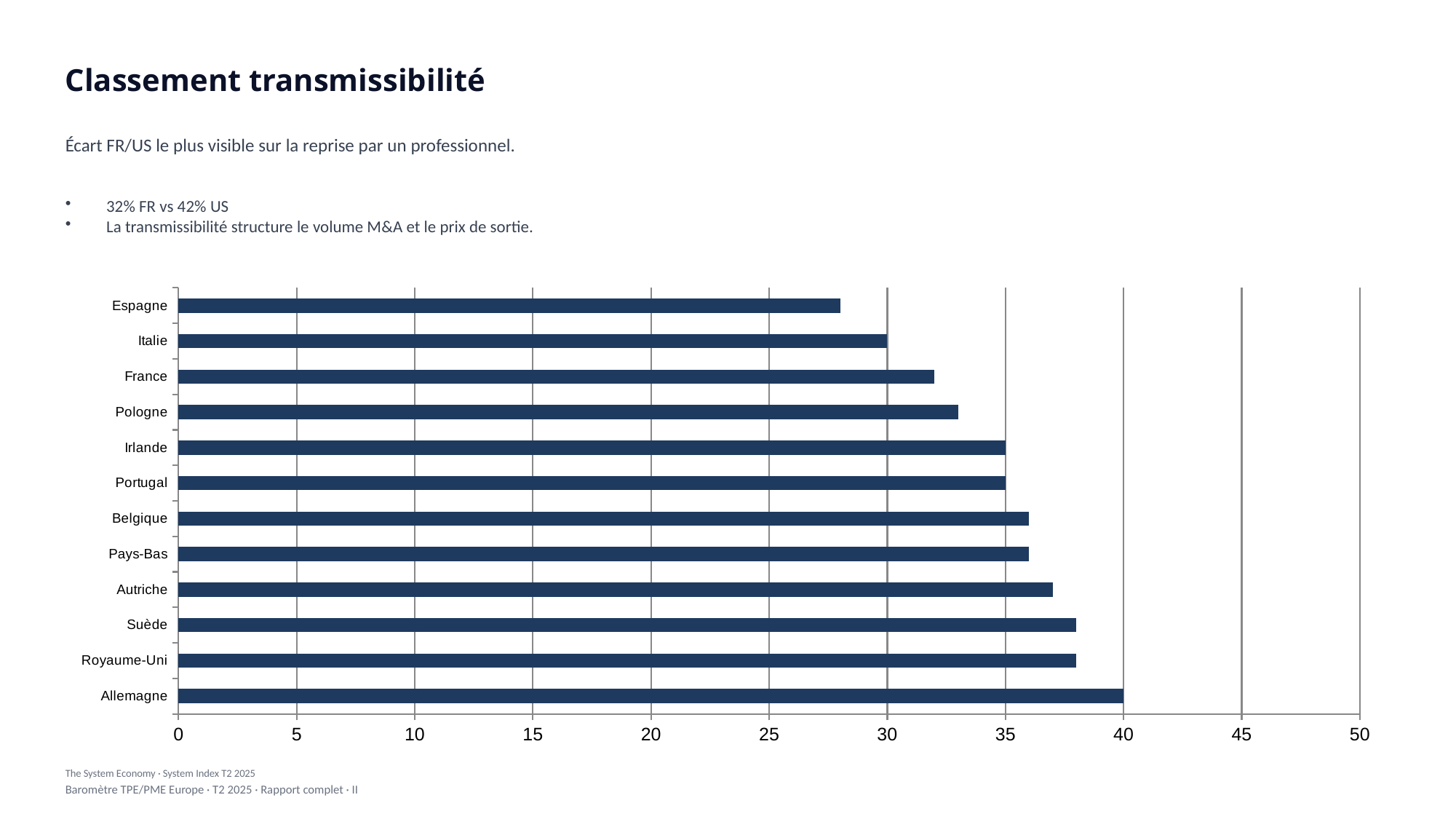
Which country has the lowest value in the chart? Espagne Is the value for Espagne greater or less than 30? less Which country has the highest value in the chart? Allemagne What is the difference between the values for Allemagne and Italie? 10 Is the value for France greater or less than 30? greater How many countries are plotted in the chart? 12 Which has the larger value, Pologne or Belgique? Belgique What is the value for Irlande? 35 What is the value for Italie? 30 Is the value for Autriche greater or less than 35? greater What kind of chart is shown on the slide? bar chart What is the value for Allemagne? 40